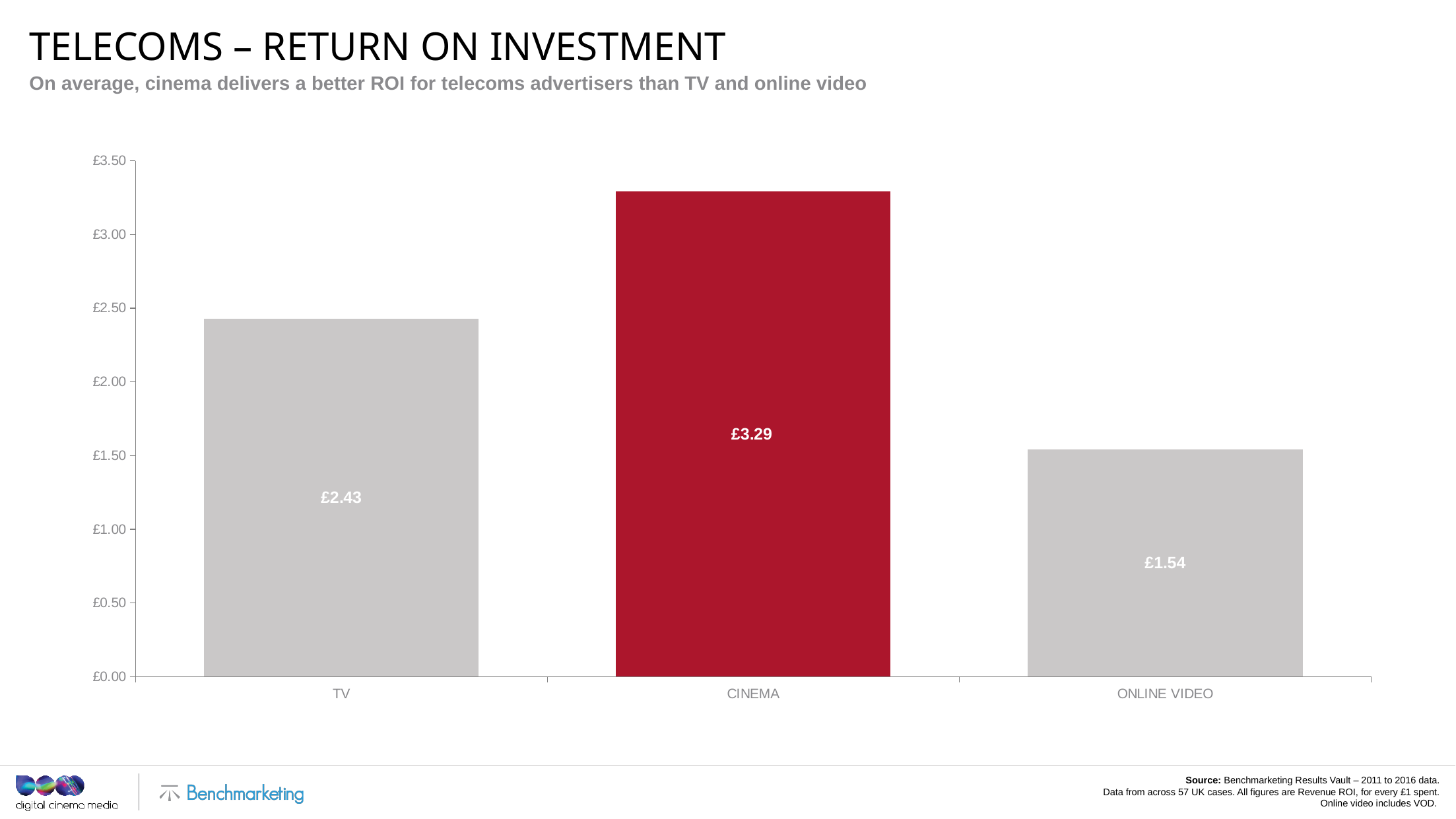
What is the difference between the ROI for TV and the ROI for ONLINE VIDEO? £0.89 Which category has the lowest ROI? ONLINE VIDEO Is the value for CINEMA greater or less than £3.00? greater Which category has the highest ROI? CINEMA What kind of chart is shown on the slide? Bar chart Which bar is coloured red rather than grey? CINEMA What is the ROI value shown for CINEMA? £3.29 How many categories are shown on the chart? 3 What is the difference between the ROI for CINEMA and the ROI for TV? £0.86 What is the ROI value shown for ONLINE VIDEO? £1.54 Which has a larger ROI, TV or ONLINE VIDEO? TV What is the ROI value shown for TV? £2.43